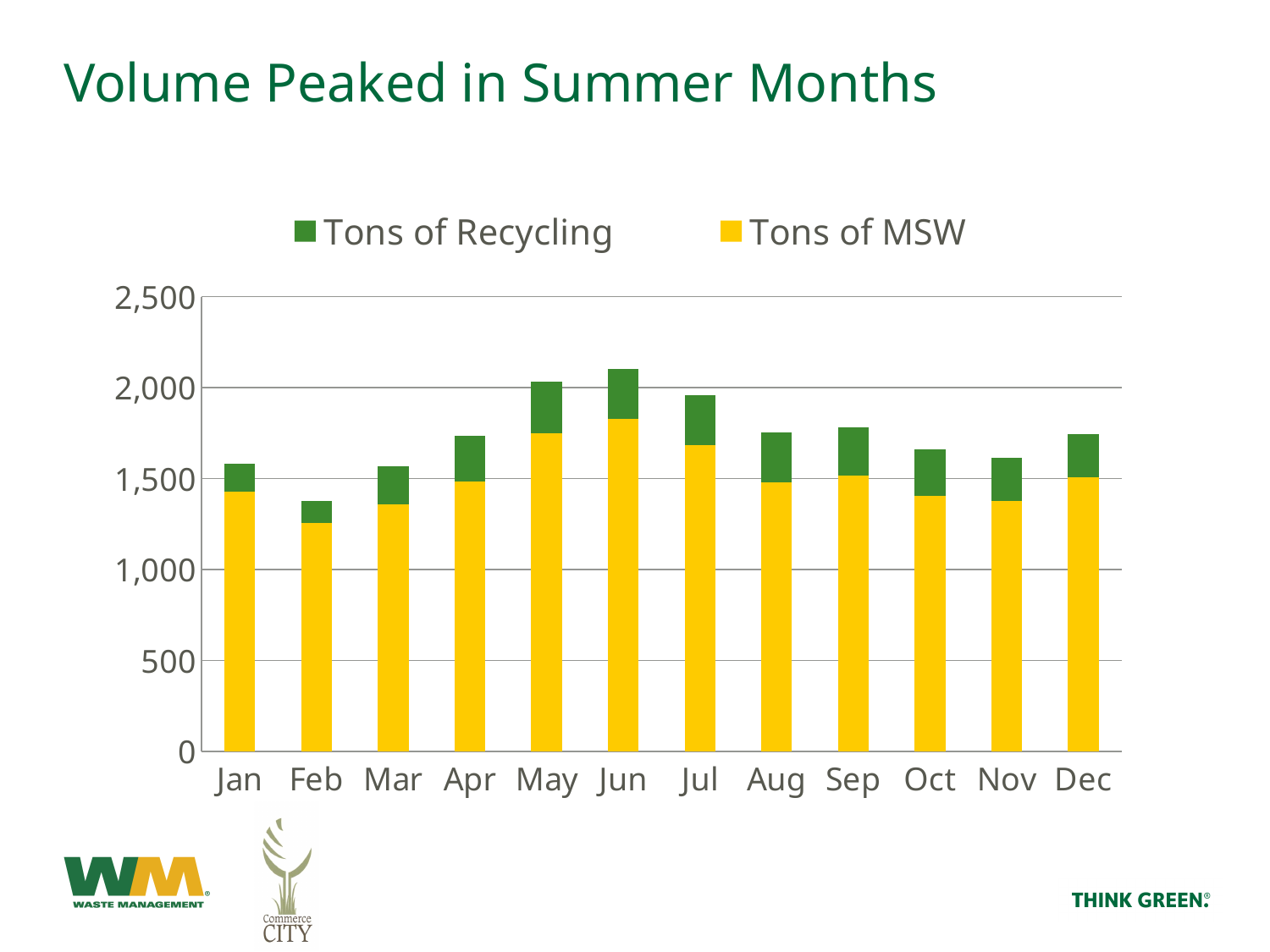
Is the total stacked bar for Feb greater or less than 1,500? less What kind of chart is shown on the slide? Stacked bar chart Is the Tons of MSW value for Jun greater or less than 1,500? greater Which month has the highest total stacked bar? Jun How many months are shown on the x axis? 12 Which colour represents Tons of Recycling in the legend? Green Do the total stacked bars rise or fall from Feb to Jun? rise Which month has the larger total stacked bar, May or Feb? May How many series does the legend list? 2 Is the total stacked bar for Jun greater or less than 2,000? greater What is the title of the chart on the slide? Volume Peaked in Summer Months Which month has the lowest total stacked bar? Feb